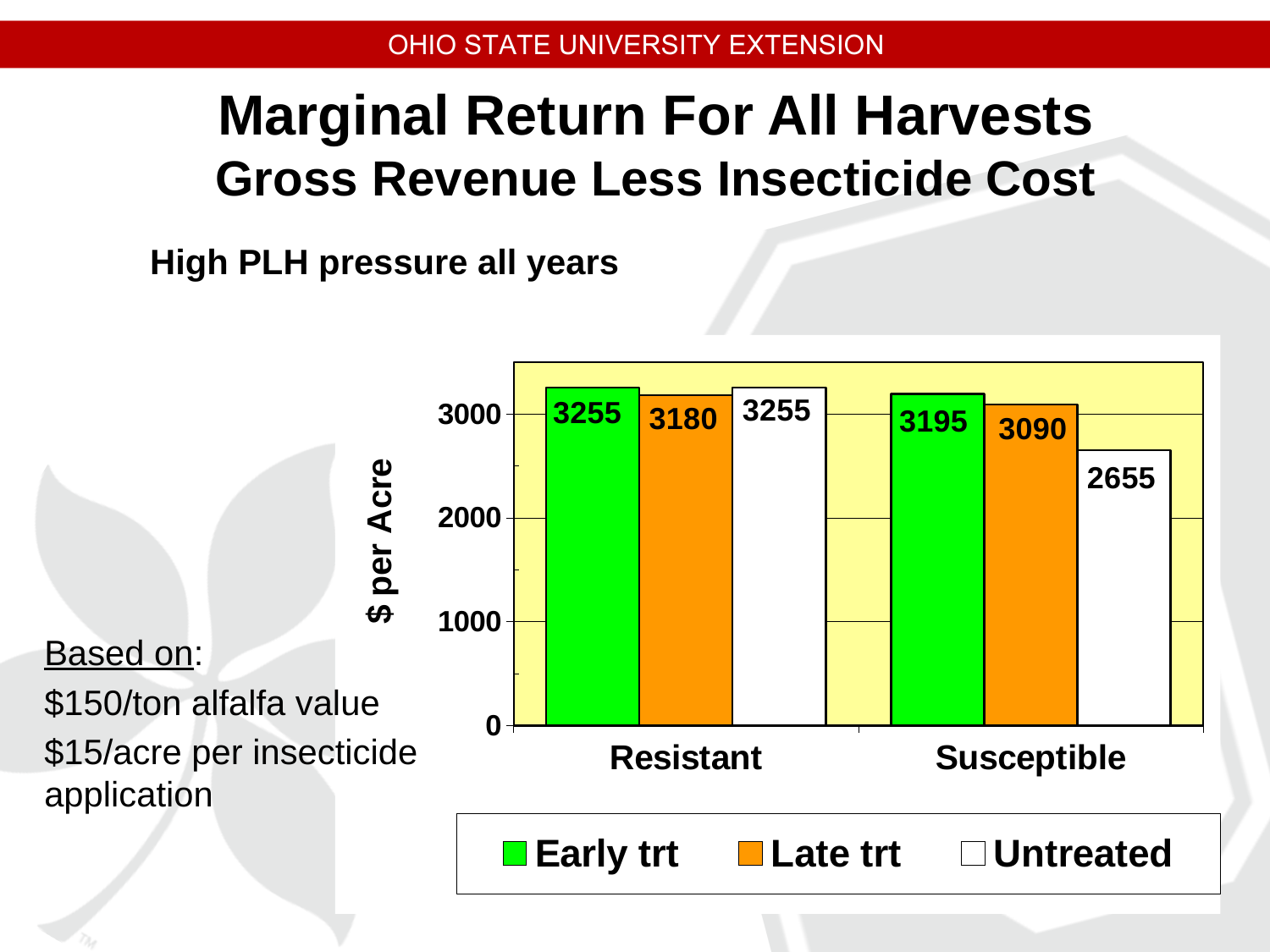
What kind of chart is shown on the slide? bar chart What is the label of the y axis? $ per Acre What is the value for Early trt in the Resistant category? 3255 What is the value for Late trt in the Resistant category? 3180 Which series has the lowest value in the Susceptible category? Untreated What is the difference between the Untreated values for Resistant and Susceptible? 600 What is the value for Untreated in the Susceptible category? 2655 What is the value for Late trt in the Susceptible category? 3090 Is the value for Untreated in the Susceptible category greater or less than 3000? less Which is larger, Early trt for Resistant or Early trt for Susceptible? Early trt for Resistant What is the difference between Early trt and Late trt in the Susceptible category? 105 How many series does the legend list? 3